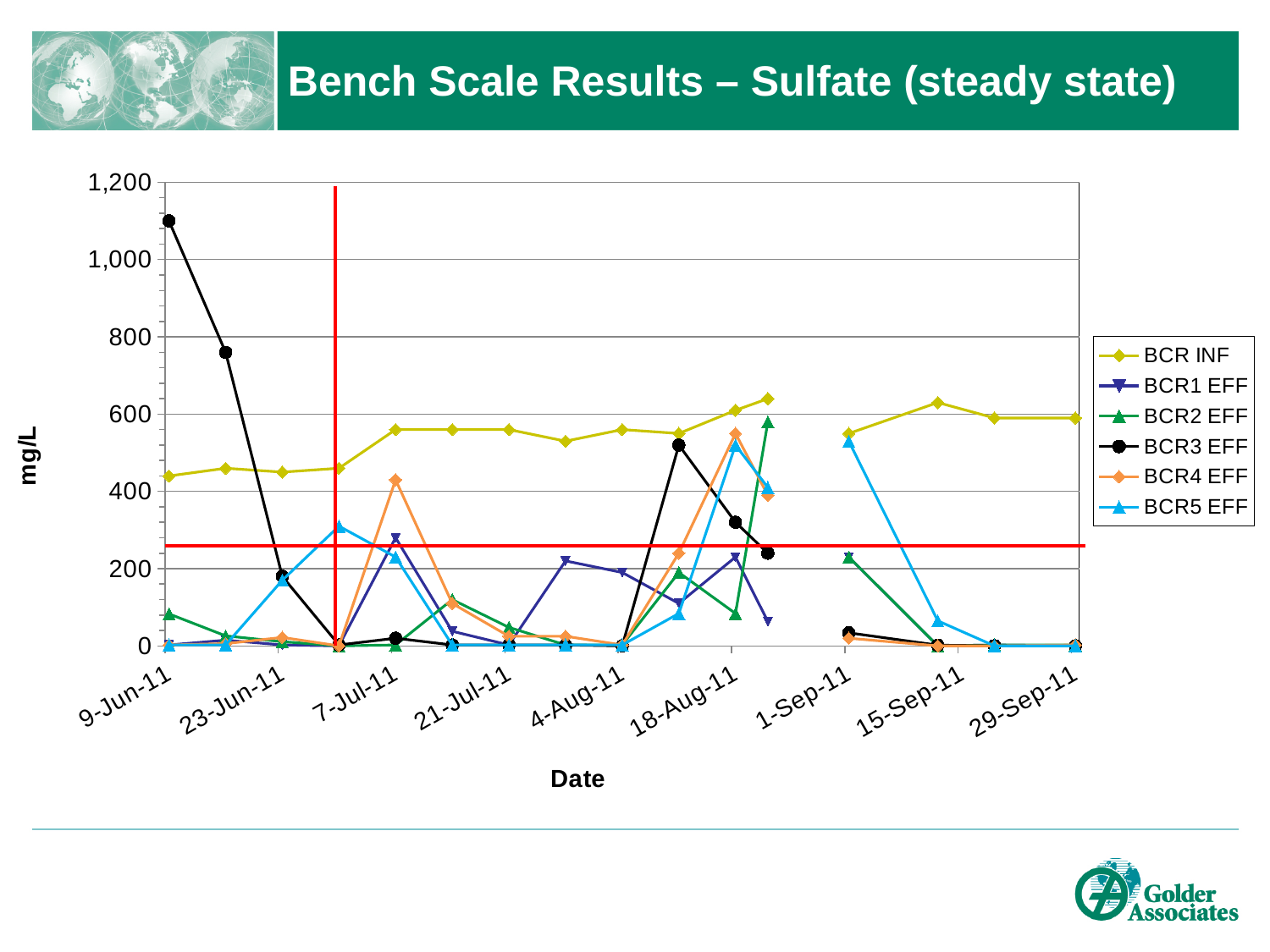
What kind of chart is shown on the slide? line chart What unit is shown on the vertical axis label? mg/L What are the series names listed in the legend? BCR INF, BCR1 EFF, BCR2 EFF, BCR3 EFF, BCR4 EFF, BCR5 EFF What is the highest tick value shown on the vertical axis? 1,200 Does the BCR3 EFF series rise or fall between 9-Jun-11 and 7-Jul-11? fall Is the value for BCR3 EFF on 23-Jun-11 greater or less than 600? less Is the value for BCR INF on 29-Sep-11 greater or less than 400? greater Which series has the highest value on 9-Jun-11? BCR3 EFF On 9-Jun-11, which is larger: BCR3 EFF or BCR INF? BCR3 EFF How many series does the legend list? 6 Which series has the highest value on 29-Sep-11? BCR INF Is the value for BCR3 EFF on 9-Jun-11 greater or less than 1,000? greater